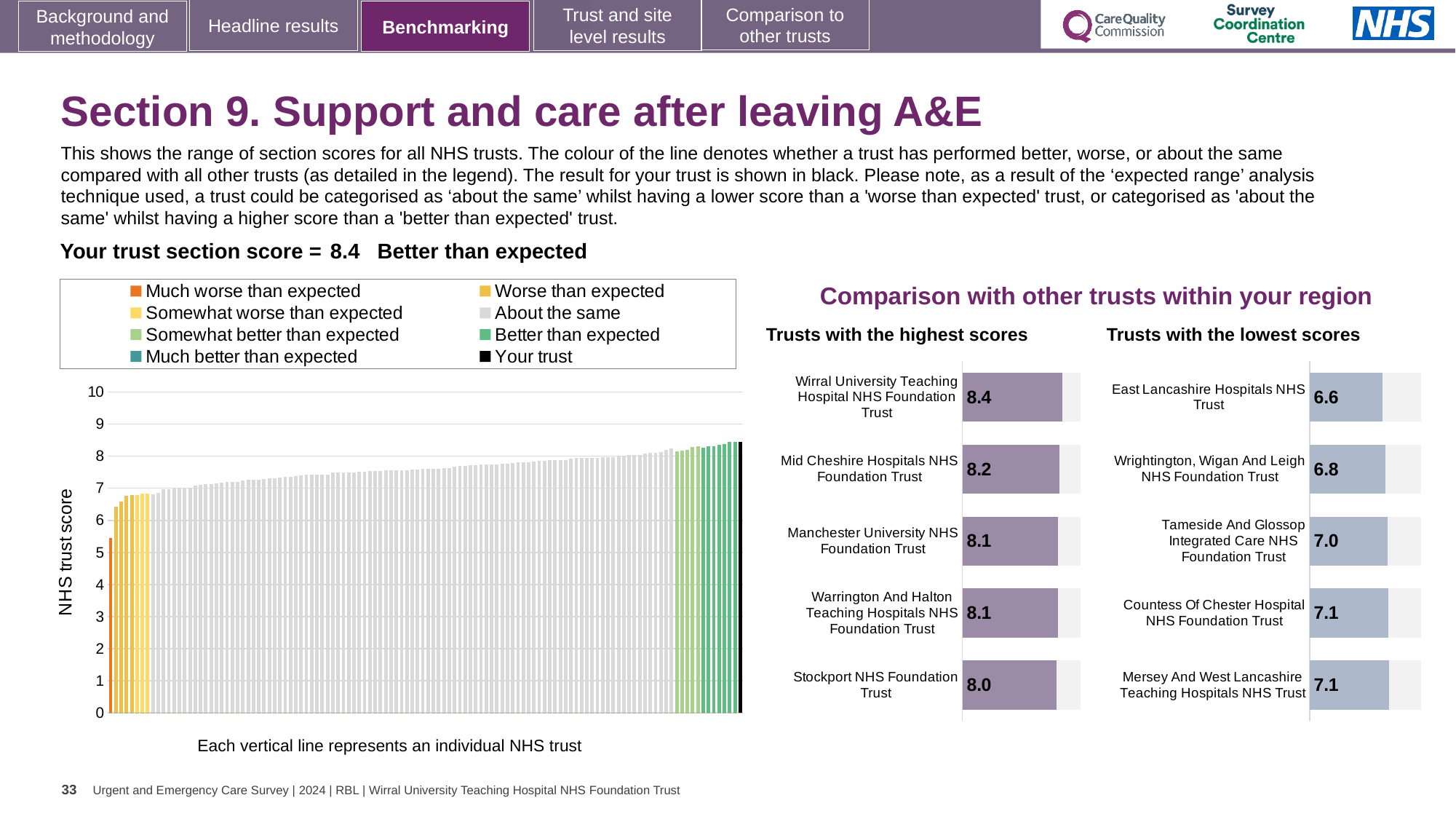
In the 'Trusts with the lowest scores' chart, which trust has the lowest score? East Lancashire Hospitals NHS Trust How many trusts are shown in the 'Trusts with the lowest scores' chart? 5 In the 'Trusts with the lowest scores' chart, which has the larger score: East Lancashire Hospitals NHS Trust or Wrightington, Wigan And Leigh NHS Foundation Trust? Wrightington, Wigan And Leigh NHS Foundation Trust In the main chart on the left, is the value of the leftmost orange bar greater or less than 6? less How many entries does the legend of the main chart on the left list? 8 In the 'Trusts with the highest scores' chart, what is the score for Mid Cheshire Hospitals NHS Foundation Trust? 8.2 In the main chart on the left, do the bar values rise or fall from left to right? rise In the 'Trusts with the highest scores' chart, which trust has the highest score? Wirral University Teaching Hospital NHS Foundation Trust In the 'Trusts with the highest scores' chart, what is the difference between the scores of Wirral University Teaching Hospital NHS Foundation Trust and Stockport NHS Foundation Trust? 0.4 In the 'Trusts with the lowest scores' chart, what is the score for Tameside And Glossop Integrated Care NHS Foundation Trust? 7.0 What type of chart is the 'Trusts with the highest scores' chart? bar chart In the 'Trusts with the lowest scores' chart, what is the difference between the scores of Countess Of Chester Hospital NHS Foundation Trust and East Lancashire Hospitals NHS Trust? 0.5